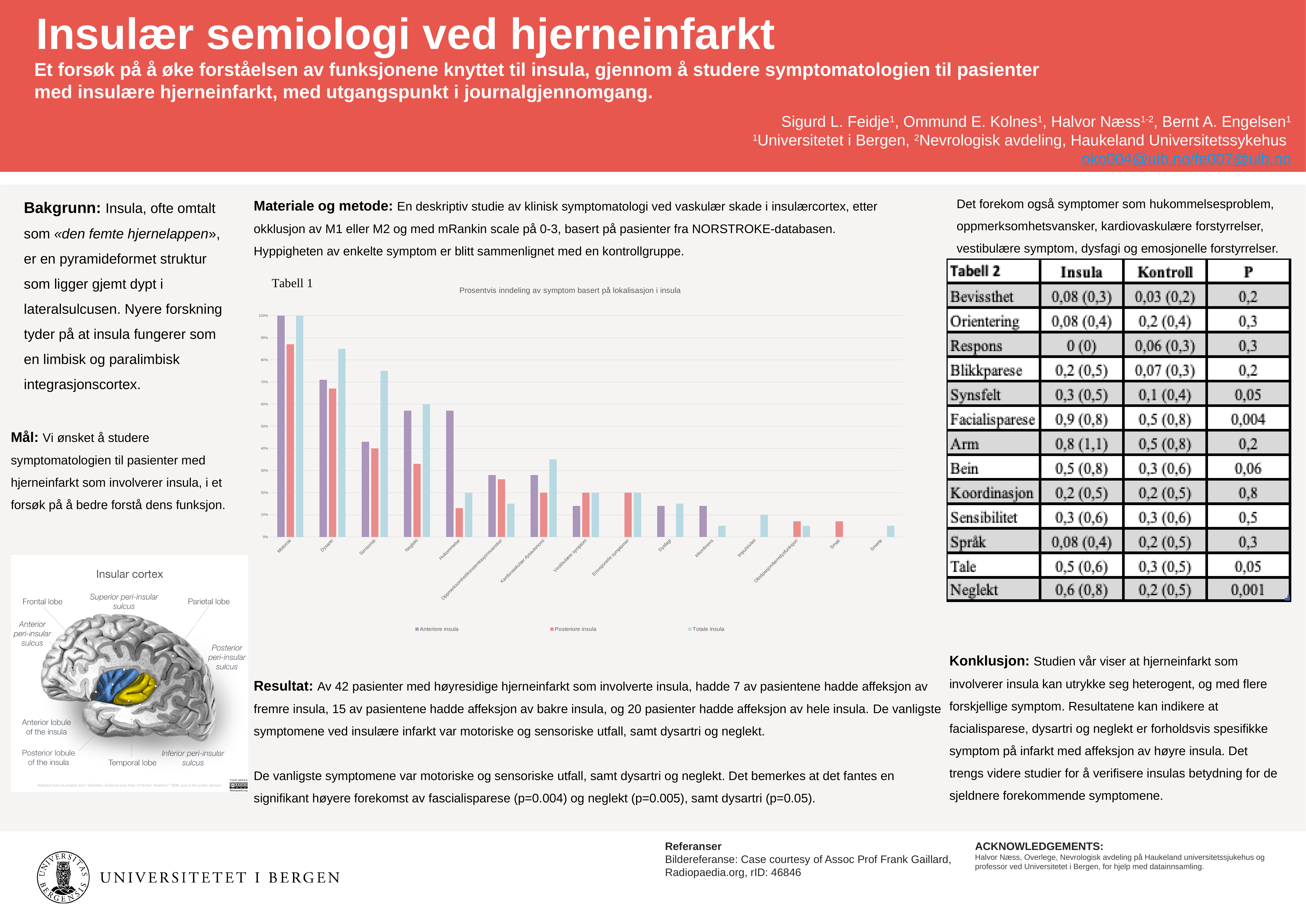
Is the Totale insula value for Dysartri greater or less than 80%? greater Is the Anteriore insula value for Hukommelse greater or less than 50%? greater For Sensorisk, which is larger: the Anteriore insula value or the Totale insula value? Totale insula Do the Totale insula values generally rise or fall from left to right across the categories? fall Is the Posteriore insula value for Neglekt greater or less than 40%? less What is the title of the bar chart? Prosentvis inndeling av symptom basert på lokalisasjon i insula What is the Anteriore insula value for Motorisk? 100% What kind of chart is shown under 'Tabell 1'? bar chart How many series does the legend of the chart list? 3 Which category has the highest Totale insula value? Motorisk What are the three series listed in the chart legend? Anteriore insula, Posteriore insula, Totale insula How many symptom categories are plotted along the x axis of the chart? 15